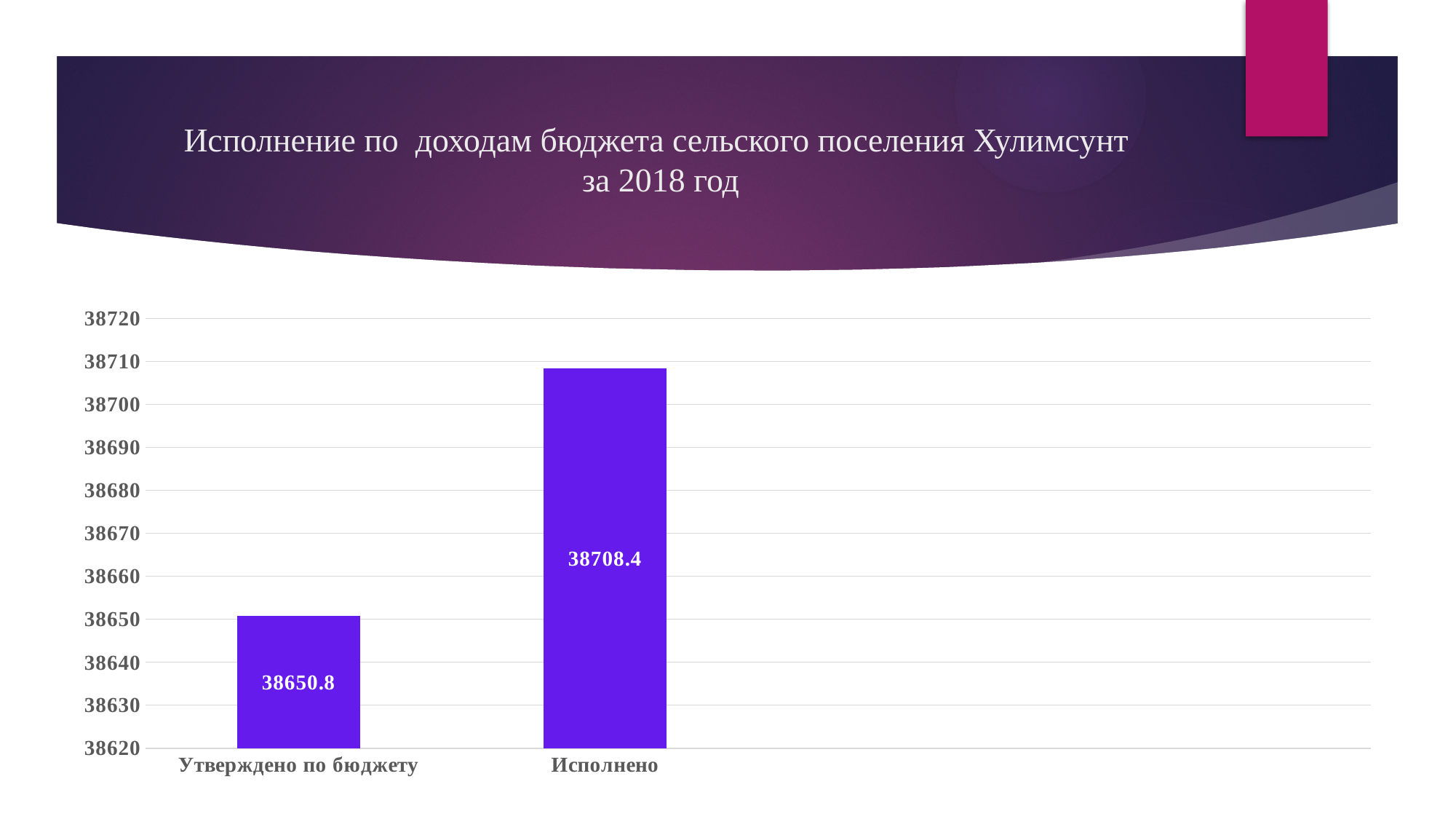
What is the difference between the values for Исполнено and Утверждено по бюджету? 57.6 Which category has the lowest value? Утверждено по бюджету What is the value for Исполнено? 38708.4 What is the value for Утверждено по бюджету? 38650.8 Which category has the highest value? Исполнено How many categories are shown on the chart? 2 What kind of chart is shown on the slide? bar chart What is the title of the slide? Исполнение по доходам бюджета сельского поселения Хулимсунт за 2018 год Do the values rise or fall from left to right along the x axis? rise Which is larger, the value for Утверждено по бюджету or the value for Исполнено? Исполнено Is the value for Исполнено greater or less than 38700? greater Is the value for Утверждено по бюджету greater or less than 38660? less